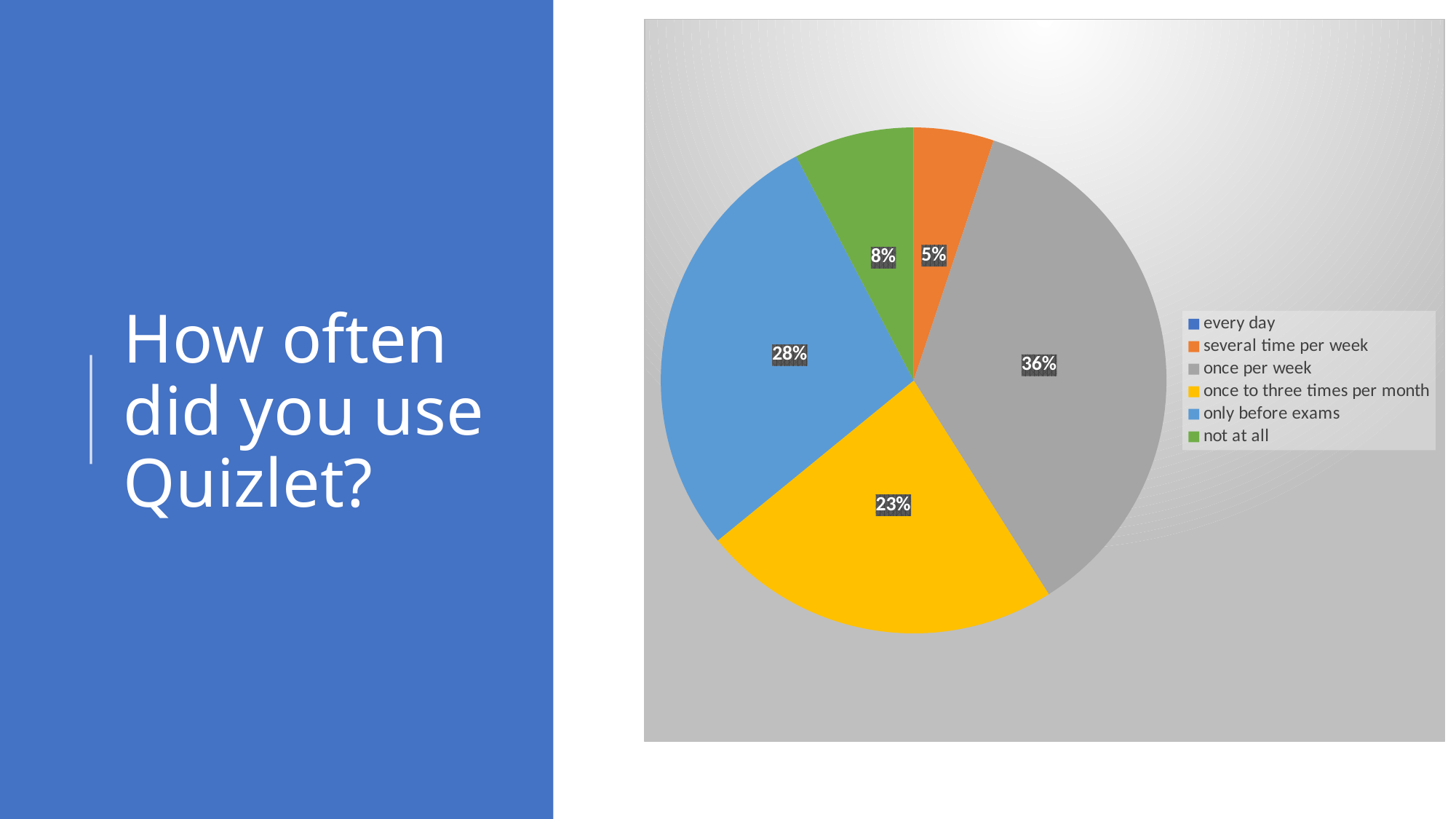
What percentage is shown for "several time per week"? 5% How many entries does the legend list? 6 What colour is the slice for "once to three times per month"? yellow What percentage is shown for "only before exams"? 28% What is the difference in percentage points between "once per week" and "only before exams"? 8 What percentage is shown for "not at all"? 8% What kind of chart is shown on the slide? pie chart Which labelled slice is the smallest in the pie? several time per week Which is larger, the slice for "only before exams" or the slice for "once to three times per month"? only before exams Which category has the largest slice of the pie? once per week What percentage is shown for "once to three times per month"? 23% What share of the pie is labelled for "once per week"? 36%